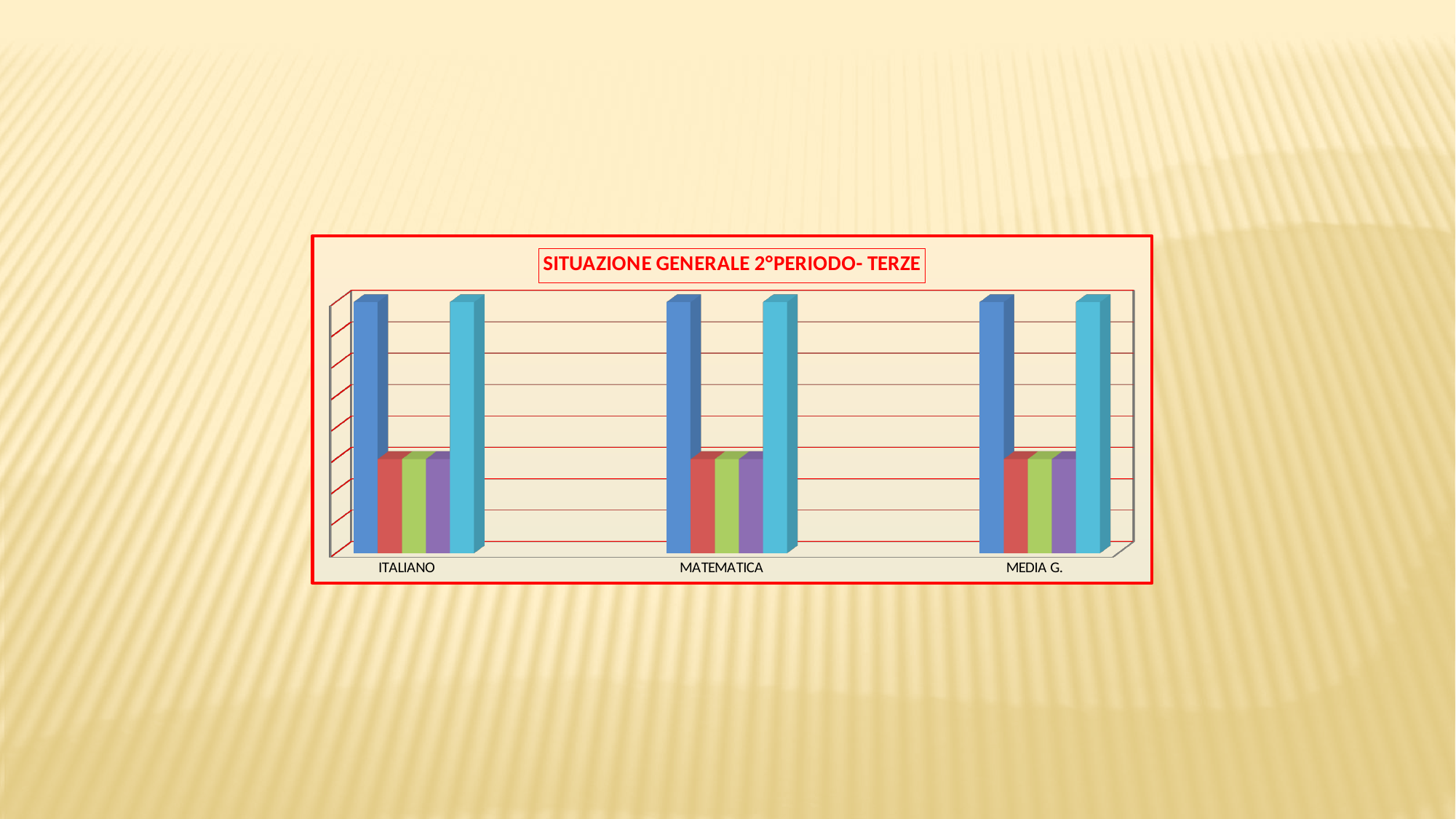
How many bars are plotted for the ITALIANO category? 5 In the MATEMATICA category, is the light blue bar or the green bar taller? light blue bar What kind of chart is shown on the slide? bar chart How many categories are shown on the x axis of the chart? 3 Which category label appears in the middle of the x axis? MATEMATICA In the ITALIANO category, is the dark blue bar or the red bar taller? dark blue bar What is the title of the chart? SITUAZIONE GENERALE 2°PERIODO- TERZE What are the category labels on the x axis of the chart? ITALIANO, MATEMATICA, MEDIA G. In the MEDIA G. category, is the purple bar or the dark blue bar taller? dark blue bar